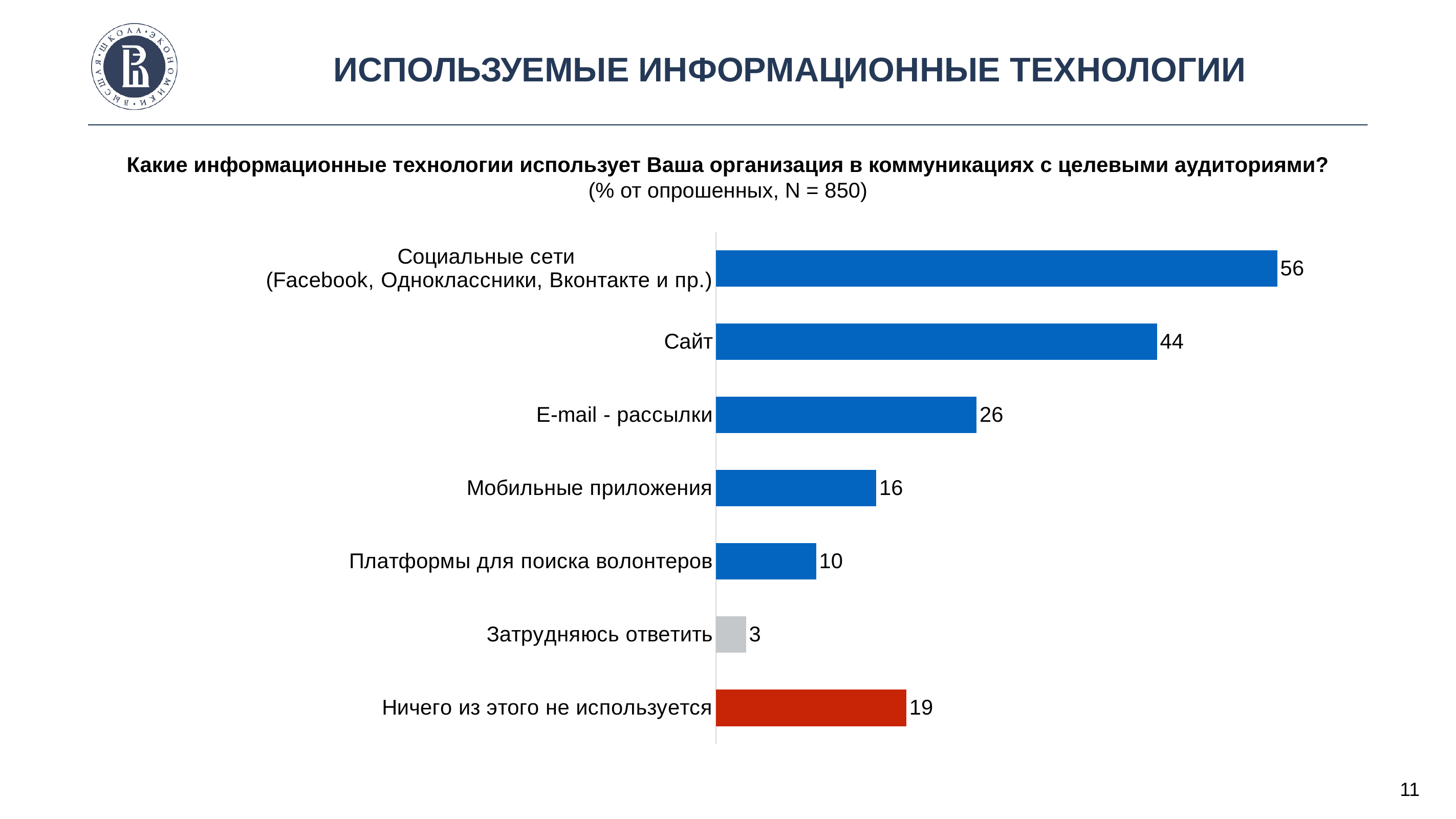
How many categories are shown in the chart? 7 Which category's bar is coloured red? Ничего из этого не используется What is the difference between the values for Ничего из этого не используется and Платформы для поиска волонтеров? 9 What is the value for Мобильные приложения? 16 What is the value for Ничего из этого не используется? 19 Which category has the highest value? Социальные сети (Facebook, Одноклассники, Вконтакте и пр.) What is the value for E-mail - рассылки? 26 What is the difference between the values for Социальные сети and Сайт? 12 Which is larger, the value for Мобильные приложения or the value for Ничего из этого не используется? Ничего из этого не используется What is the value for Сайт? 44 Which category has the lowest value? Затрудняюсь ответить What kind of chart is shown on the slide? Bar chart